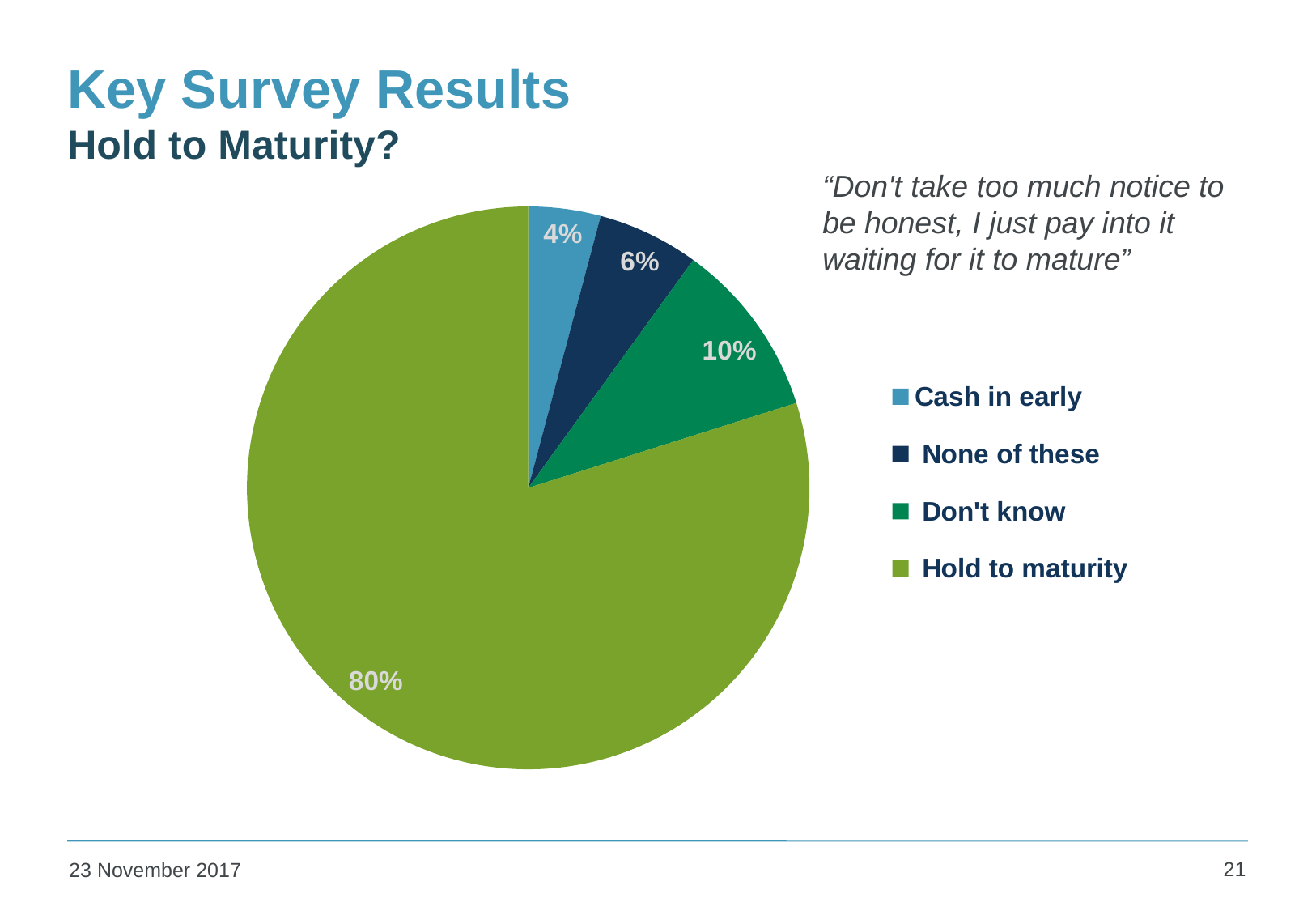
What percentage of respondents said they would cash in early? 4% What percentage of respondents answered 'None of these'? 6% How many categories does the pie chart show? 4 Which category has the largest share of the pie? Hold to maturity Which is larger, the share for 'None of these' or the share for 'Cash in early'? None of these What is the difference in percentage points between 'Hold to maturity' and 'Don't know'? 70 What is the combined share of 'Cash in early' and 'None of these'? 10% Which colour represents 'Don't know' in the legend? Green What percentage of respondents said they would hold to maturity? 80% What percentage of respondents answered 'Don't know'? 10% What kind of chart is shown on the slide? Pie chart Which category has the smallest share of the pie? Cash in early